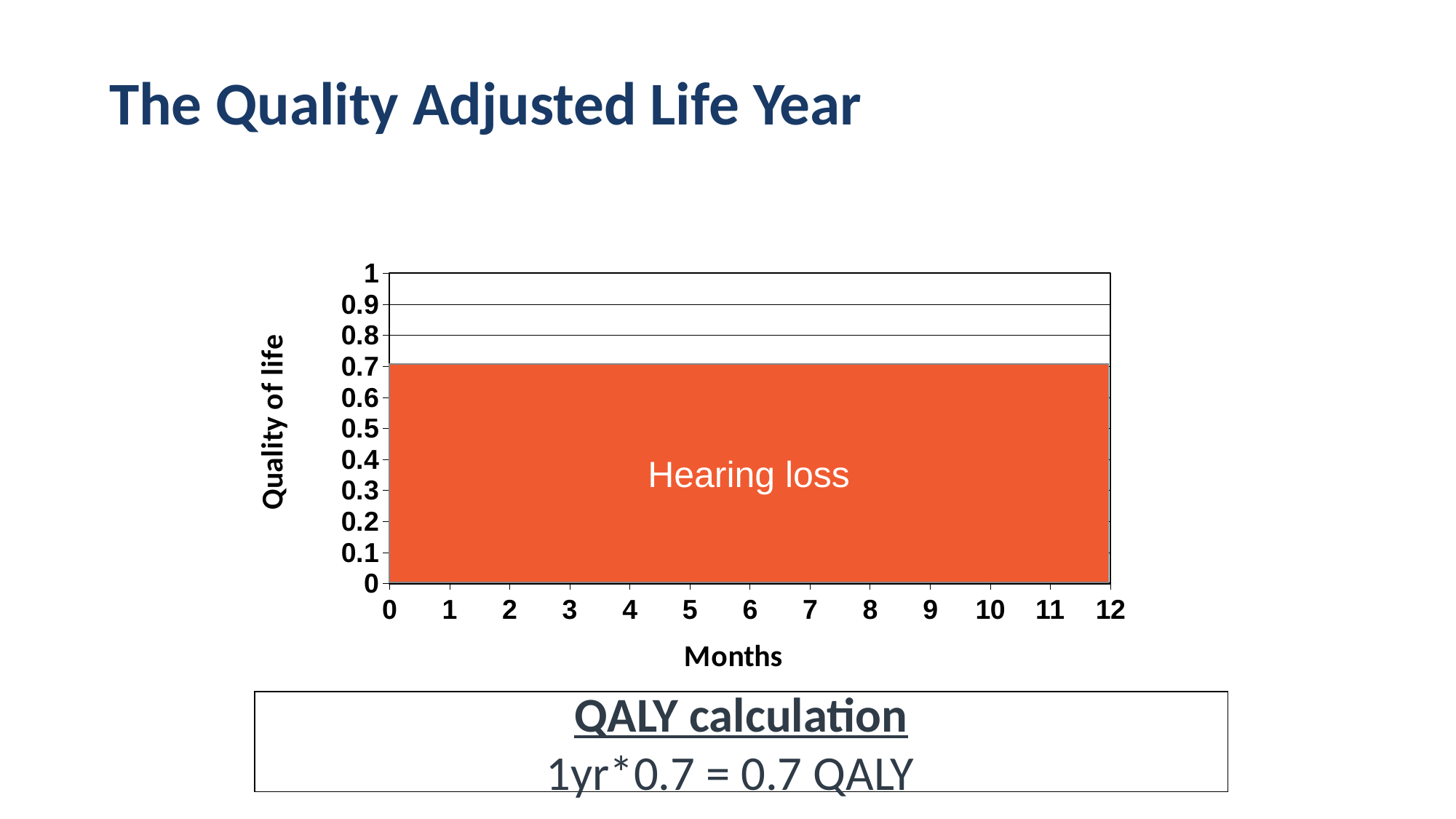
What kind of chart is shown on the slide? area chart Is the quality of life value for hearing loss greater or less than 0.5? greater Is the quality of life value for hearing loss greater or less than 0.8? less Does the quality of life value rise, fall, or stay constant across the months on the x axis? stays constant What is the last month shown on the x axis? 12 What is the quality of life value shown for hearing loss at month 6? 0.7 What is the highest value shown on the y axis? 1 What is the quality of life value for hearing loss at month 12? 0.7 What is the label on the y axis of the chart? Quality of life What condition is labelled on the shaded area of the chart? Hearing loss What is the label on the x axis of the chart? Months Is the quality of life value for hearing loss greater or less than 1? less